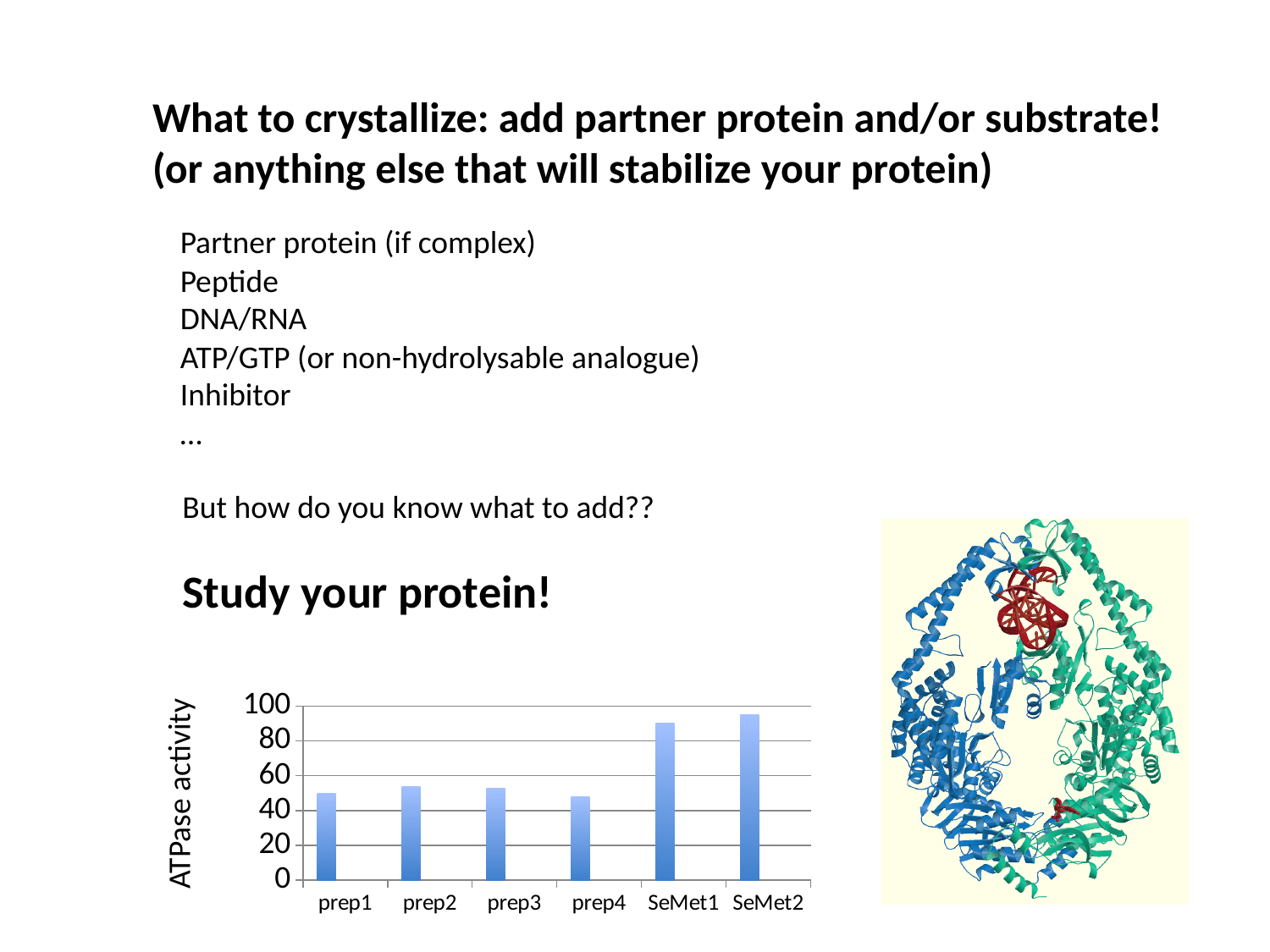
Which has higher ATPase activity, prep1 or SeMet1? SeMet1 Is the ATPase activity for prep1 greater or less than 60? less What is the highest value shown on the y axis of the bar chart? 100 Is the ATPase activity for SeMet2 greater or less than 80? greater What kind of chart is shown on the slide? bar chart How many categories are shown on the x axis of the bar chart? 6 Which has higher ATPase activity, prep2 or SeMet2? SeMet2 Is the ATPase activity for prep3 greater or less than 40? greater Which category is the last one on the x axis of the bar chart? SeMet2 What is the label of the y axis of the bar chart? ATPase activity